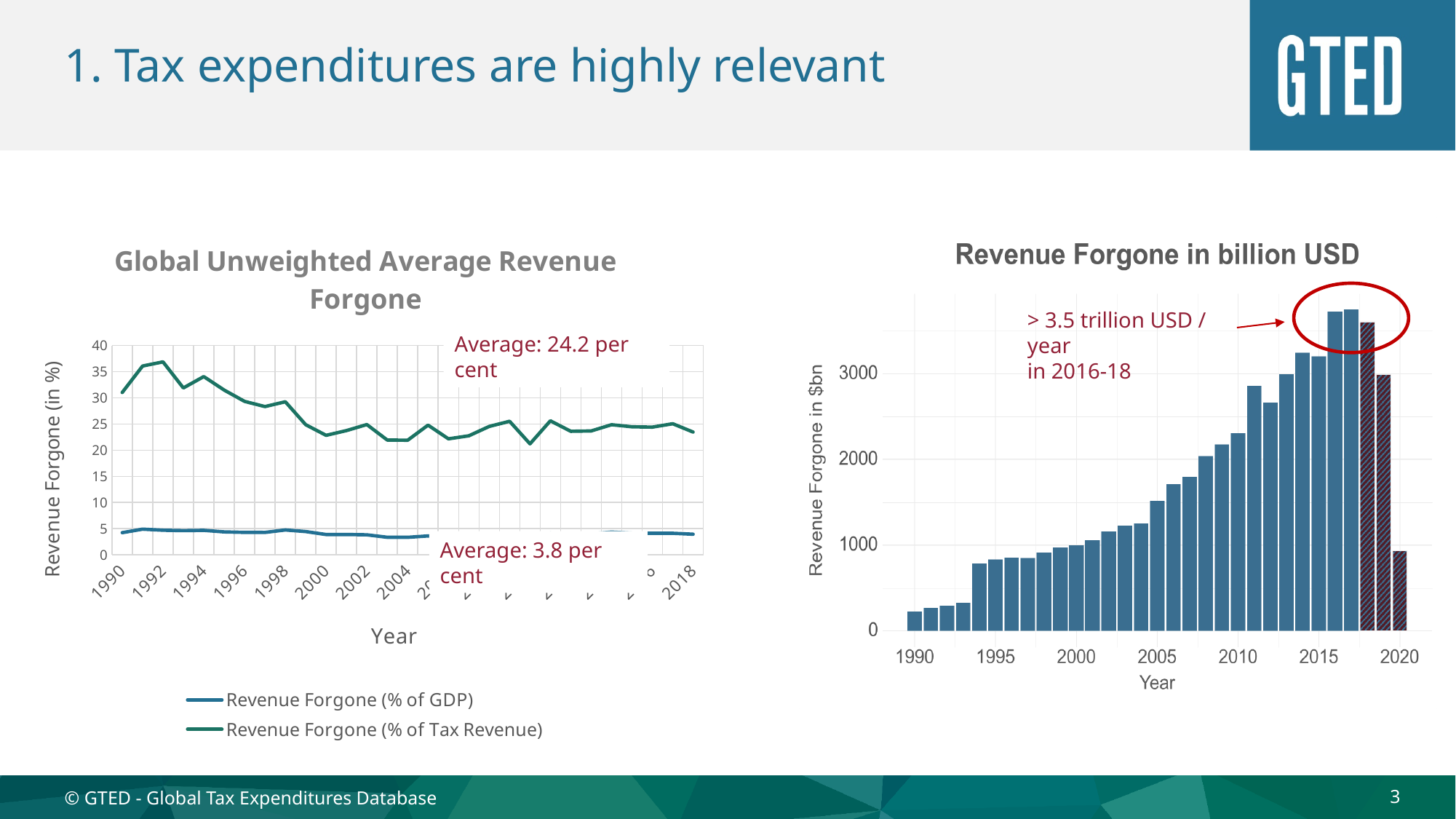
In the 'Global Unweighted Average Revenue Forgone' chart, does the Revenue Forgone (% of Tax Revenue) series overall rise or fall from 1990 to 2018? fall In the 'Revenue Forgone in billion USD' chart, do the bars generally rise or fall from 1990 to 2017? rise In the 'Revenue Forgone in billion USD' chart, which year has the larger value, 2018 or 2019? 2018 In the 'Global Unweighted Average Revenue Forgone' chart, is the Revenue Forgone (% of Tax Revenue) value for 1992 greater or less than 35? greater What kind of chart is the 'Global Unweighted Average Revenue Forgone' chart on the left? line chart In the 'Global Unweighted Average Revenue Forgone' chart, is the Revenue Forgone (% of GDP) value for 1990 greater or less than 5? less In the 'Revenue Forgone in billion USD' chart, which year has the lowest bar? 1990 In the 'Revenue Forgone in billion USD' chart, is the value for 2020 greater or less than 1000? less How many series does the legend of the 'Global Unweighted Average Revenue Forgone' chart list? 2 In the 'Global Unweighted Average Revenue Forgone' chart, which series has the higher values throughout, Revenue Forgone (% of GDP) or Revenue Forgone (% of Tax Revenue)? Revenue Forgone (% of Tax Revenue) What kind of chart is the 'Revenue Forgone in billion USD' chart on the right? bar chart What average is annotated for the Revenue Forgone (% of Tax Revenue) series in the left chart? 24.2 per cent